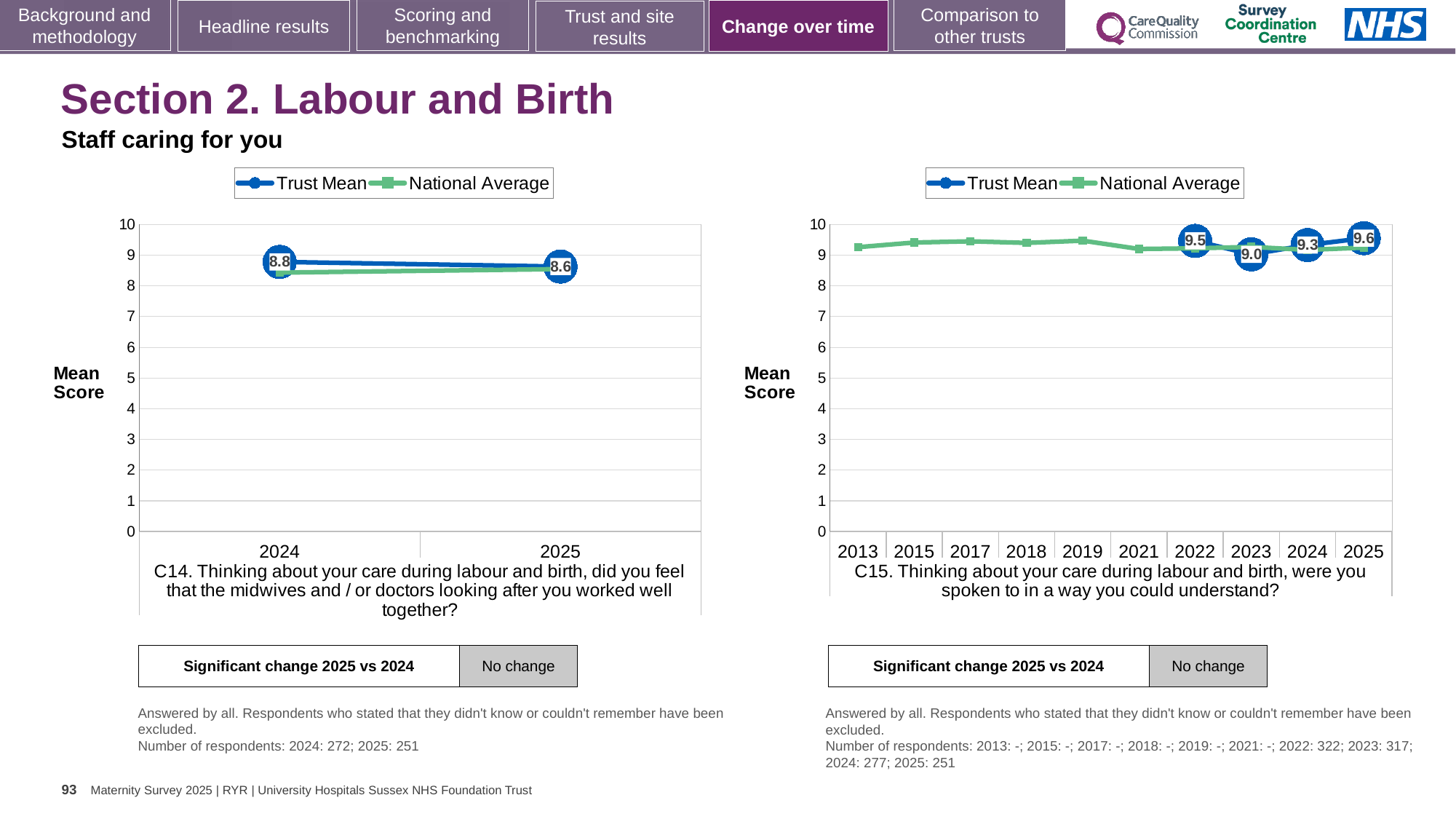
In the right chart (C15), how many years are shown on the x axis? 10 In the left chart (C14), what is the Trust Mean score for 2025? 8.6 In the left chart (C14), by how much did the Trust Mean change from 2024 to 2025? 0.2 In the right chart (C15), which year has the lowest labelled Trust Mean score? 2023 In the right chart (C15), what is the difference between the Trust Mean in 2025 and in 2023? 0.6 In the left chart (C14), does the Trust Mean rise or fall from 2024 to 2025? fall In the right chart (C15), which year has the highest labelled Trust Mean score? 2025 In the left chart (C14), what is the Trust Mean score for 2024? 8.8 In the right chart (C15), what is the Trust Mean score for 2025? 9.6 In the right chart (C15), what is the Trust Mean score for 2023? 9.0 How many series does the legend of the left chart (C14) list? 2 In the right chart (C15), is the National Average value for 2013 greater or less than 8? greater